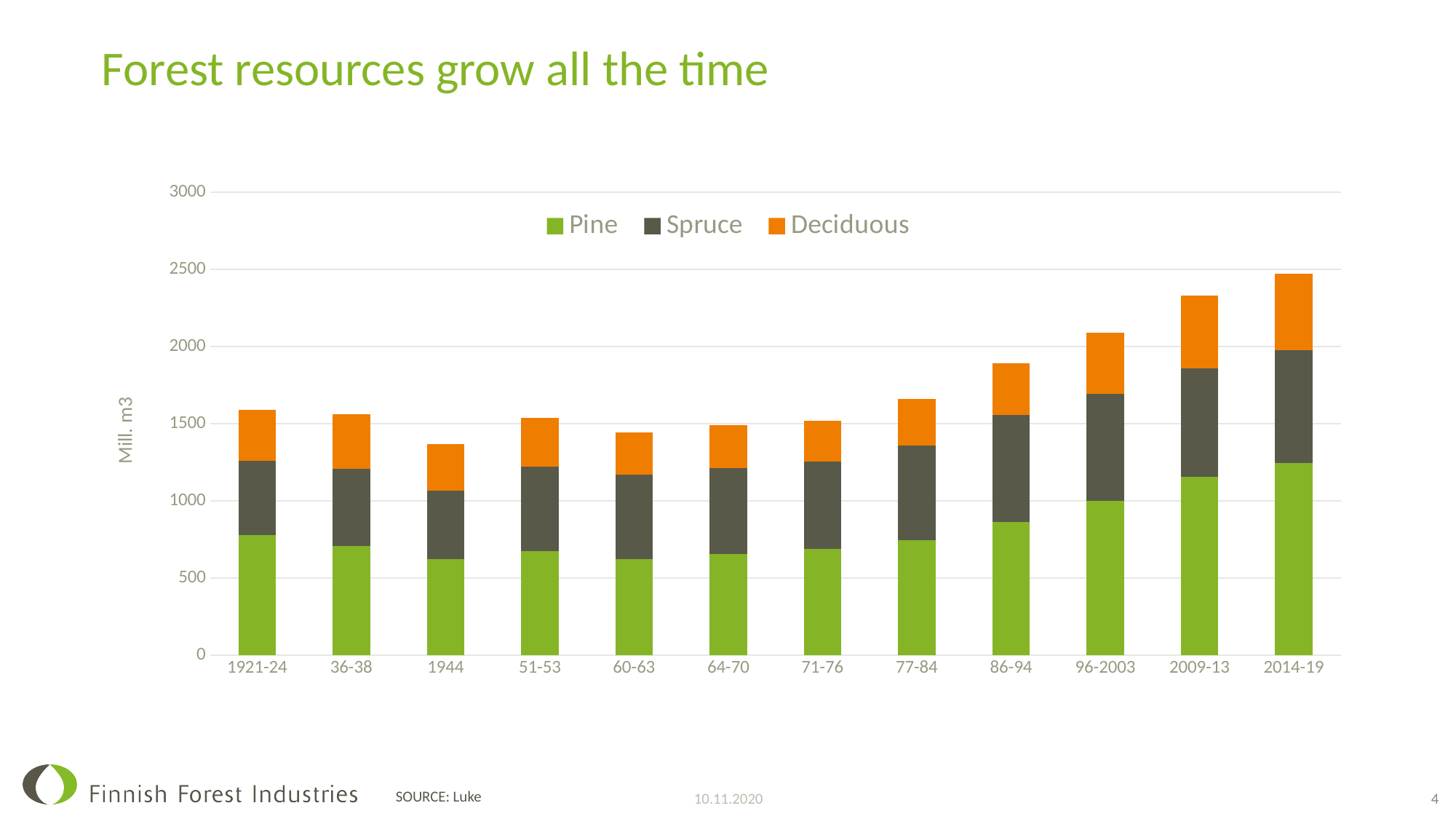
Is the total value for 1944 greater or less than 1500? less Which period has the lowest total stacked bar? 1944 Is the Pine value for 2014-19 greater or less than 1000? greater Which period has a larger Pine value, 96-2003 or 1944? 96-2003 What kind of chart is shown on the slide? Stacked bar chart How many time periods are shown on the x axis? 12 Do the total stacked bar values rise or fall from 1944 to 2014-19? rise How many series does the legend list? 3 Is the total value for 2014-19 greater or less than 2000? greater Which period has a larger total stacked bar, 2009-13 or 1921-24? 2009-13 What is the label on the y axis? Mill. m3 Which period has the highest total stacked bar? 2014-19